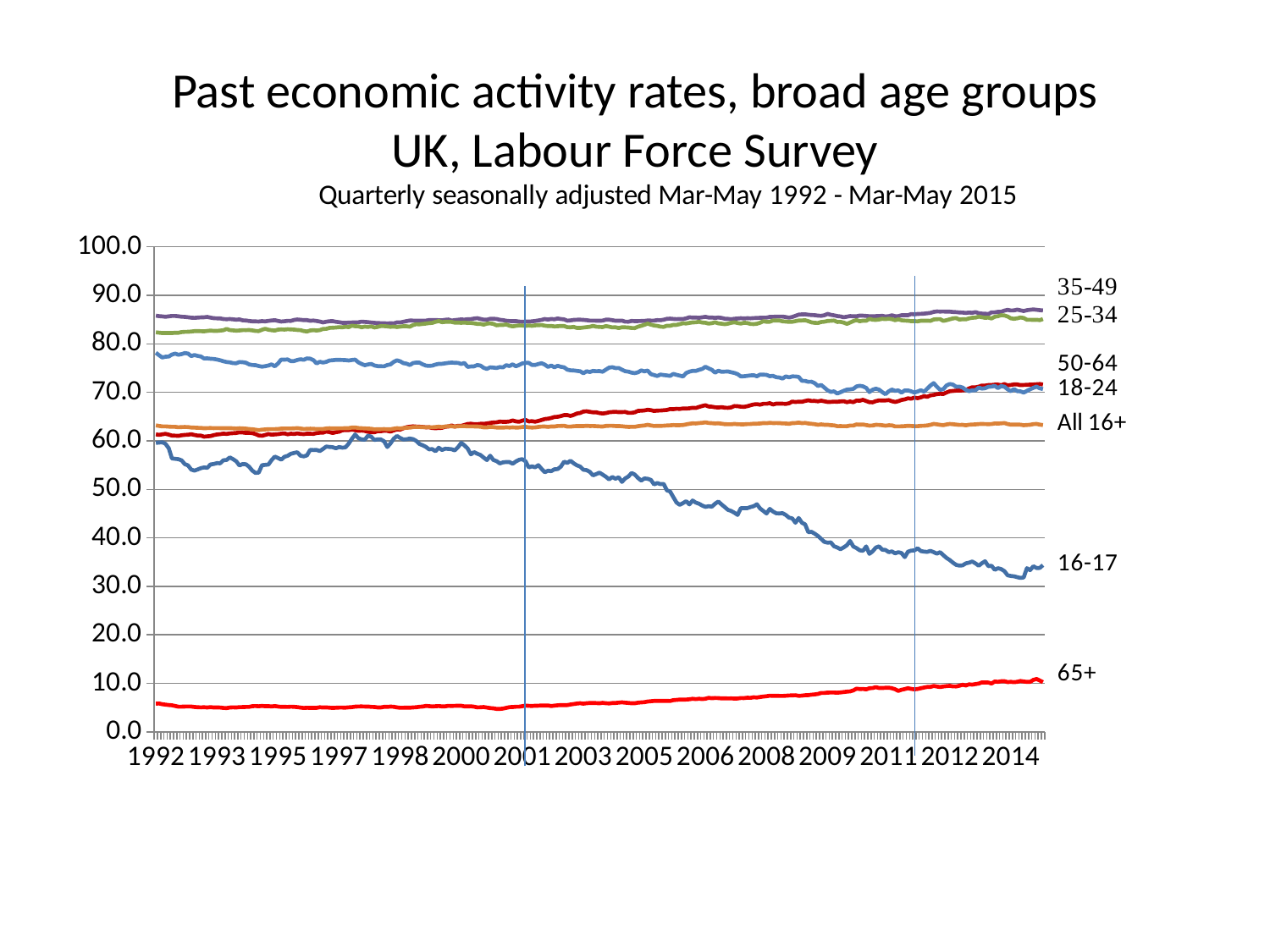
Does the economic activity rate for the 16-17 age group rise or fall from 1992 to 2015? fall What is the title of the chart? Quarterly seasonally adjusted Mar-May 1992 - Mar-May 2015 At the end of the period, which is larger: the rate for 18-24 or the rate for 16-17? 18-24 Is the economic activity rate for the 35-49 age group in 2014 greater or less than 80.0? greater Does the economic activity rate for the 65+ age group rise or fall over the period shown? rise Which age group has the highest economic activity rate across the period? 35-49 Is the economic activity rate for the 65+ age group in 1992 greater or less than 10.0? less How many age-group series are plotted on the chart? 7 Does the economic activity rate for the 50-64 age group rise or fall from 1992 to 2015? rise Is the economic activity rate for the 16-17 age group in 2014 greater or less than 40.0? less What kind of chart is shown on the slide? line chart Which age group has the lowest economic activity rate across the period? 65+